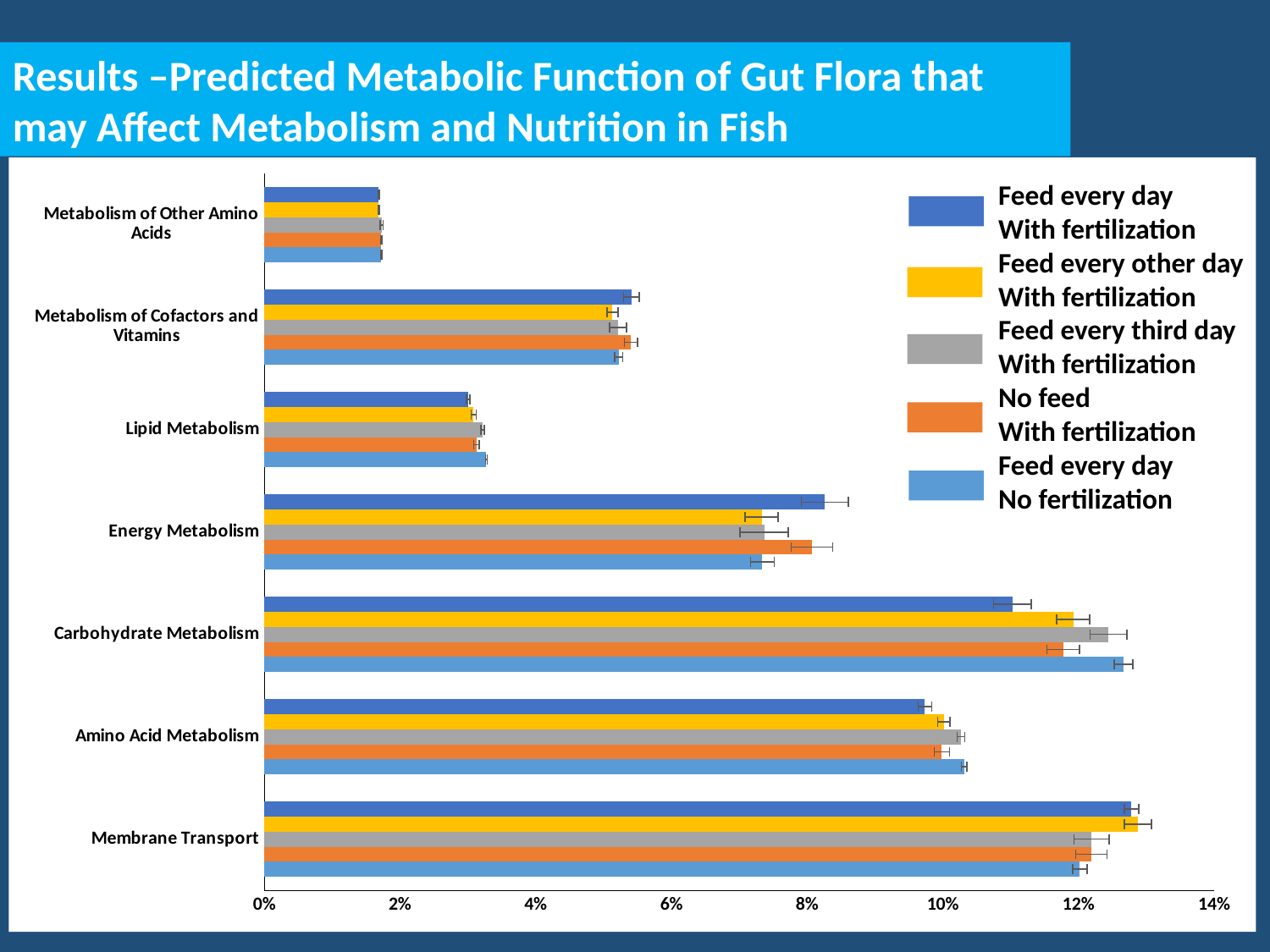
What kind of chart is shown on the slide? bar chart How many series does the legend list? 5 What colour represents the 'No feed With fertilization' series in the legend? orange Is the value for Metabolism of Other Amino Acids under 'Feed every day With fertilization' greater or less than 2%? less For Carbohydrate Metabolism, which is larger: the value for 'Feed every day With fertilization' or 'Feed every day No fertilization'? Feed every day No fertilization Is the value for Lipid Metabolism under 'No feed With fertilization' greater or less than 4%? less Is the value for Amino Acid Metabolism under 'Feed every day With fertilization' greater or less than 10%? less For the 'Feed every day With fertilization' series, which category has the highest value? Membrane Transport Which category has the lowest values across all series? Metabolism of Other Amino Acids For Energy Metabolism, which is larger: the value for 'Feed every day With fertilization' or 'Feed every other day With fertilization'? Feed every day With fertilization How many metabolic function categories are plotted on the chart? 7